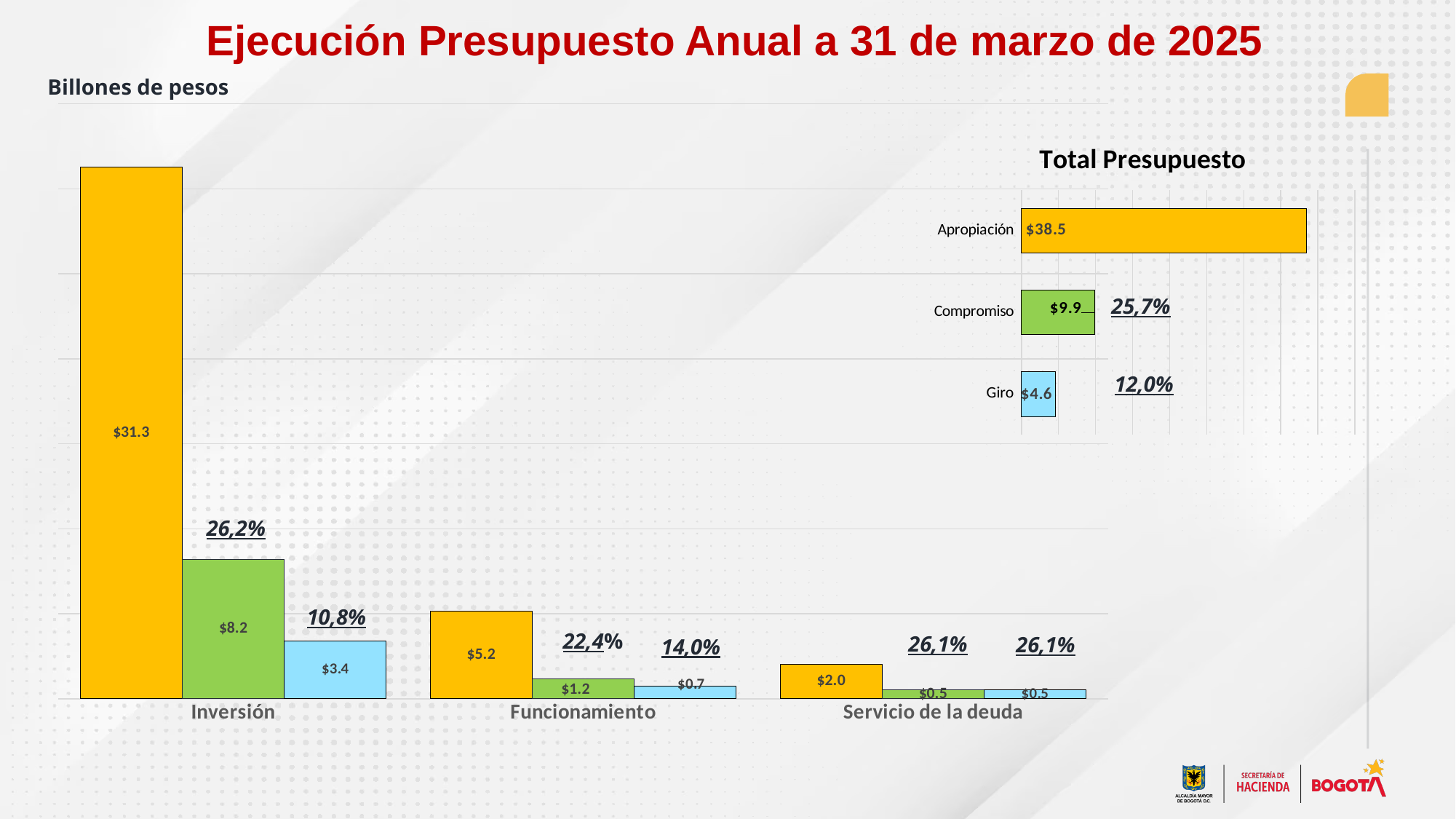
What kind of chart is the 'Total Presupuesto' chart? Bar chart In the large bar chart on the left, what is the value of the blue bar for Servicio de la deuda? $0.5 In the 'Total Presupuesto' chart, what is the difference between Apropiación and Compromiso? $28.6 In the large bar chart on the left, which category has the highest yellow bar? Inversión In the 'Total Presupuesto' chart, what is the value for Compromiso? $9.9 In the 'Total Presupuesto' chart, which category has the lowest value? Giro In the 'Total Presupuesto' chart, what is the value for Apropiación? $38.5 In the large bar chart on the left, what is the value of the green bar for Funcionamiento? $1.2 In the 'Total Presupuesto' chart, how many categories are shown? 3 In the 'Total Presupuesto' chart, what is the value for Giro? $4.6 In the large bar chart on the left, what is the value of the yellow bar for Inversión? $31.3 In the large bar chart on the left, is the yellow bar for Inversión larger or smaller than the yellow bar for Funcionamiento? Larger